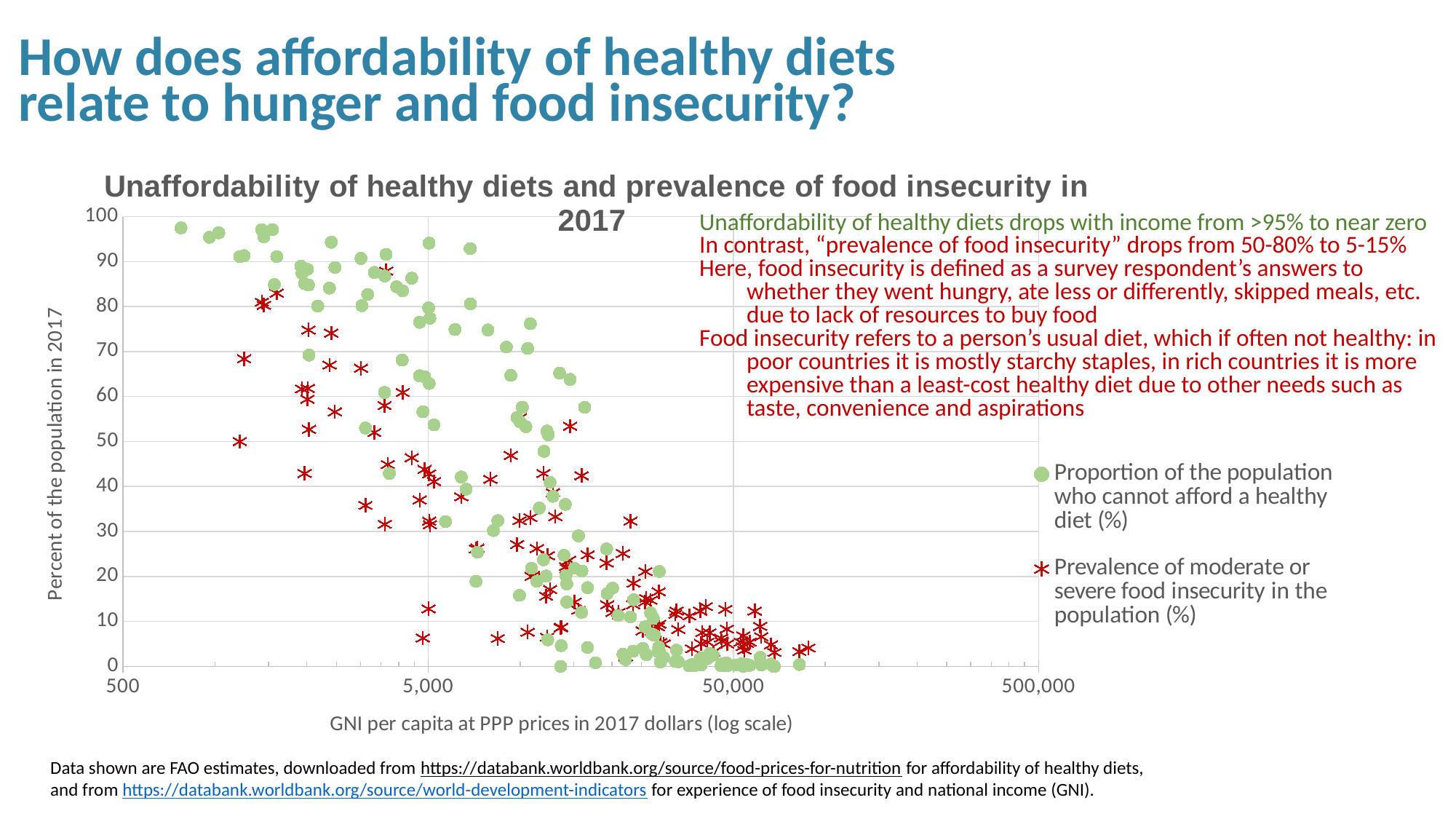
What kind of chart is shown on the slide? Scatter chart What is the title of the chart? Unaffordability of healthy diets and prevalence of food insecurity in 2017 As GNI per capita increases along the x axis, do the values for the proportion of the population who cannot afford a healthy diet rise or fall? Fall Which series is plotted with red asterisks? Prevalence of moderate or severe food insecurity in the population (%) Which series is plotted with green circles? Proportion of the population who cannot afford a healthy diet (%) As GNI per capita increases along the x axis, do the values for prevalence of moderate or severe food insecurity rise or fall? Fall How many series does the legend list? 2